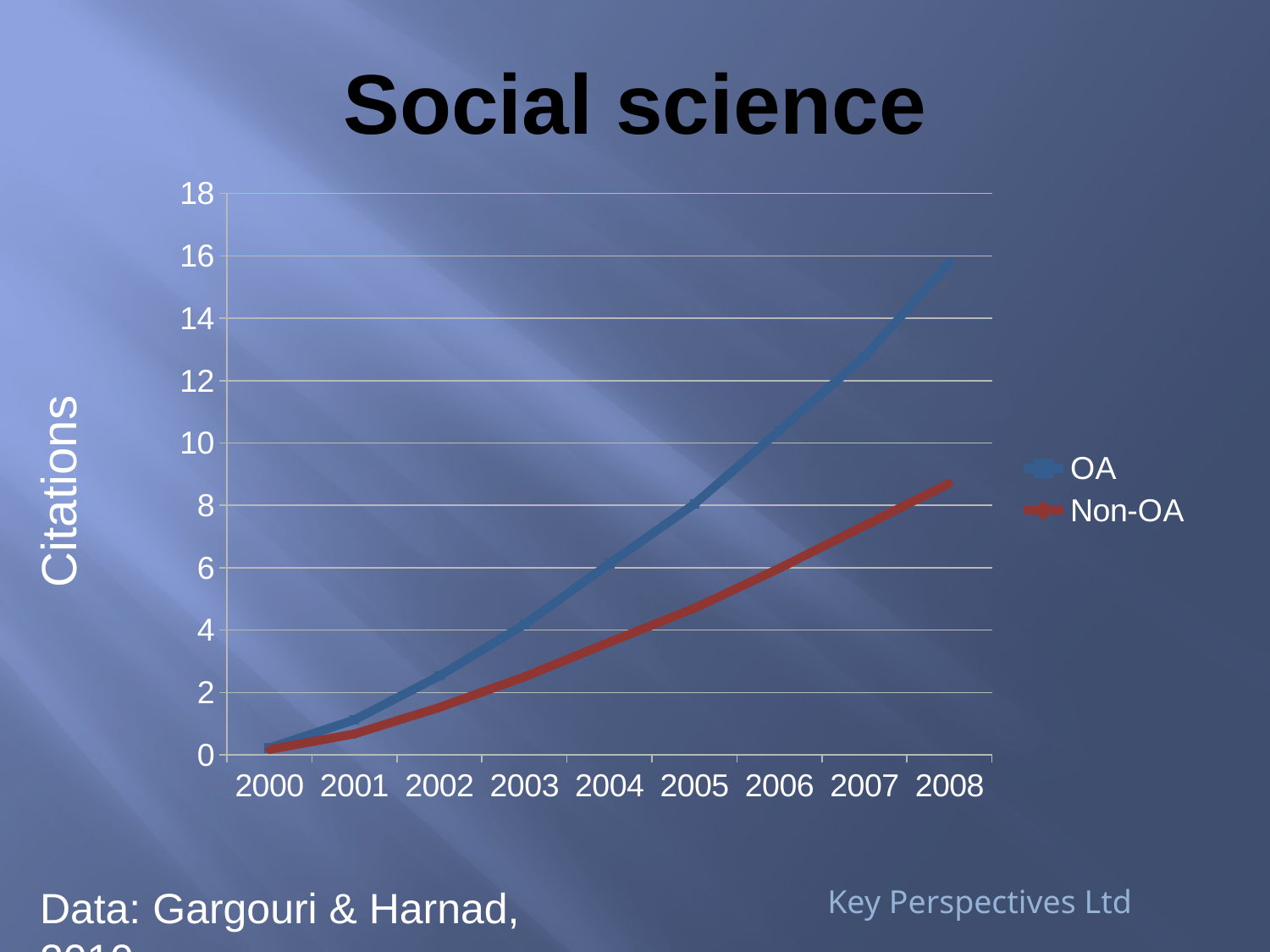
How many series does the legend list? 2 In which year is the Non-OA series at its lowest? 2000 Is the Non-OA value for 2008 greater or less than 10? less In 2008, which series has more citations, OA or Non-OA? OA Do the OA citations rise or fall from 2000 to 2008? rise What kind of chart is shown on the slide? line chart How many years are shown on the x axis? 9 In which year is the OA series at its highest? 2008 What is the label on the y axis? Citations Is the Non-OA value for 2005 greater or less than 6? less What is the title of the chart? Social science Is the OA value for 2008 greater or less than 14? greater